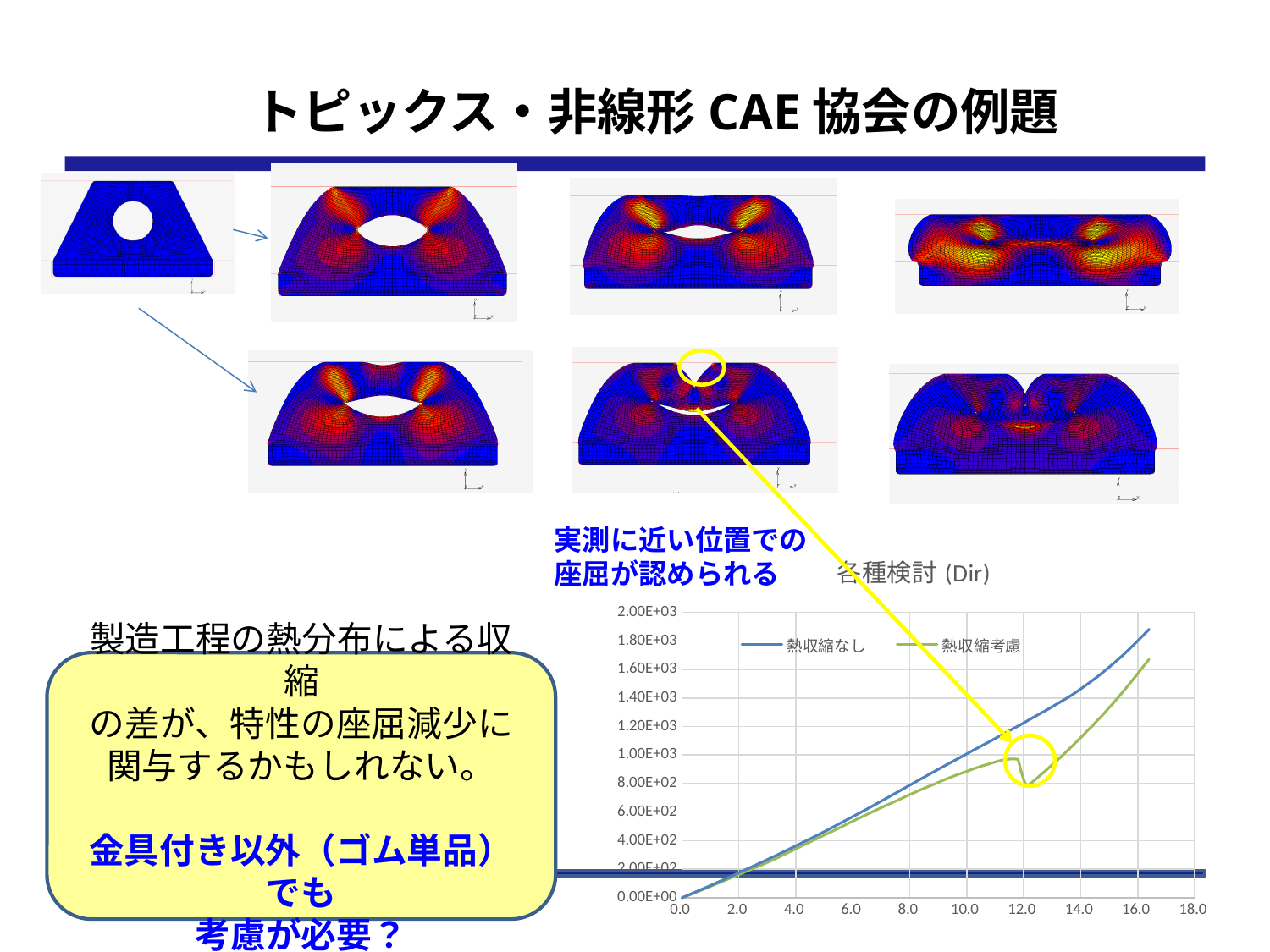
Which series shows a sudden drop near x = 12.0? 熱収縮考慮 What is the title of the chart? 各種検討 (Dir) At the right end of the chart, which series reaches the higher value? 熱収縮なし Is the value of 熱収縮考慮 at x = 12.0 greater or less than 1.00E+03? less Is the value of 熱収縮なし at x = 12.0 greater or less than 8.00E+02? greater At x = 14.0, which series has the larger value, 熱収縮なし or 熱収縮考慮? 熱収縮なし Is the value of 熱収縮なし at x = 16.0 greater or less than 1.60E+03? greater How many series does the chart legend list? 2 What are the two series named in the chart legend? 熱収縮なし and 熱収縮考慮 Does the 熱収縮なし series rise or fall as the x value increases? rise What kind of chart is shown on the slide? line chart What is the highest value shown on the chart's y axis? 2.00E+03